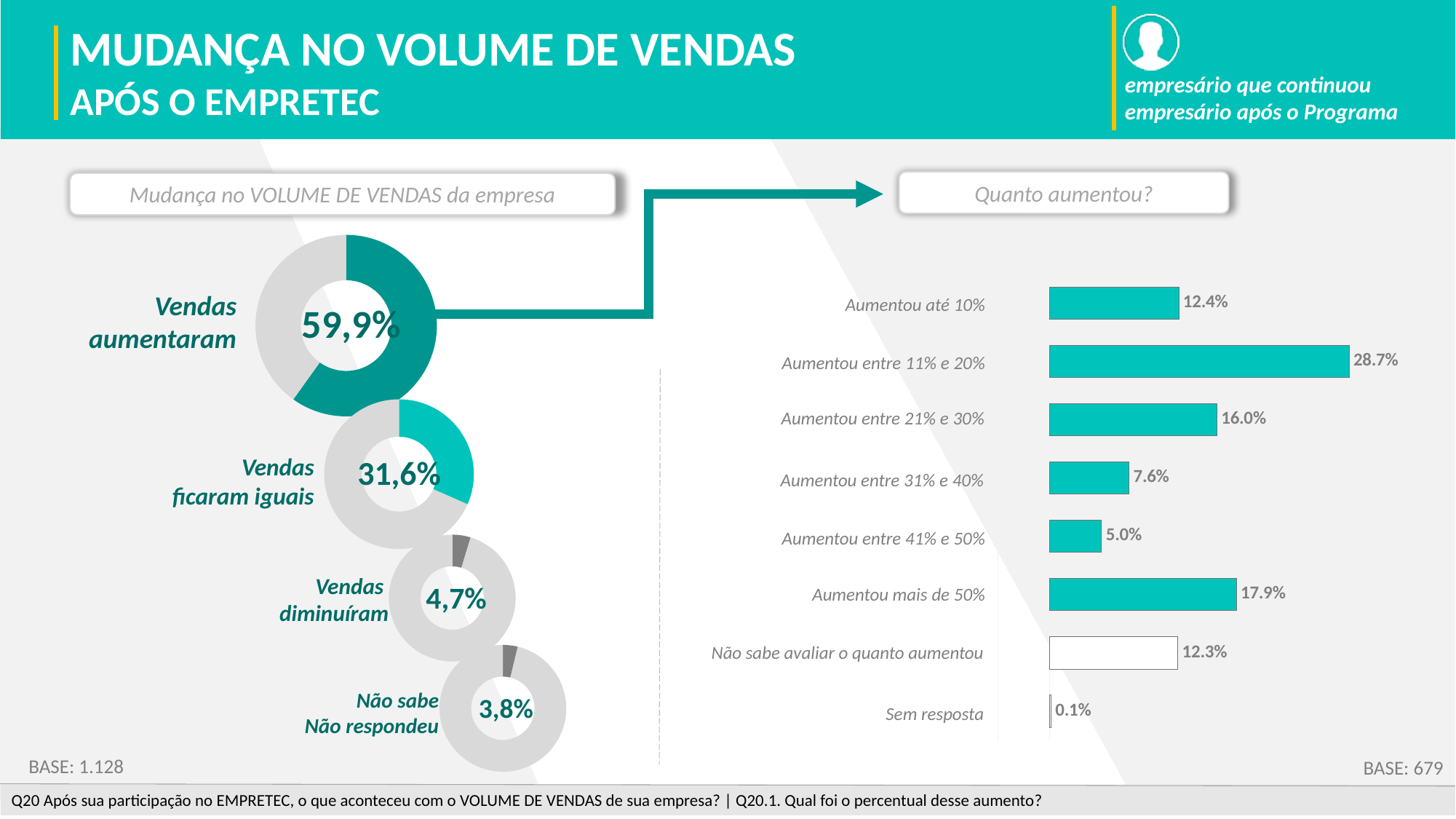
What is the base (number of respondents) shown for the 'Quanto aumentou?' chart? 679 In the 'Quanto aumentou?' chart, what is the difference between 'Aumentou entre 21% e 30%' and 'Aumentou entre 31% e 40%'? 8.4% In the 'Quanto aumentou?' chart, which category has the lowest value? Sem resposta In the 'Mudança no VOLUME DE VENDAS da empresa' chart, what percentage is shown for 'Vendas aumentaram'? 59,9% In the 'Mudança no VOLUME DE VENDAS da empresa' chart, which category has the lowest percentage? Não sabe / Não respondeu In the 'Quanto aumentou?' chart, what is the value for 'Aumentou mais de 50%'? 17.9% In the 'Quanto aumentou?' chart, which category has the highest value? Aumentou entre 11% e 20% How many categories are shown in the 'Quanto aumentou?' bar chart? 8 In the 'Mudança no VOLUME DE VENDAS da empresa' chart, what percentage is shown for 'Vendas diminuíram'? 4,7% In the 'Quanto aumentou?' chart, what is the value for 'Aumentou entre 11% e 20%'? 28.7% What type of chart is used for 'Quanto aumentou?'? Bar chart In the 'Quanto aumentou?' chart, which is larger: 'Aumentou até 10%' or 'Não sabe avaliar o quanto aumentou'? Aumentou até 10%